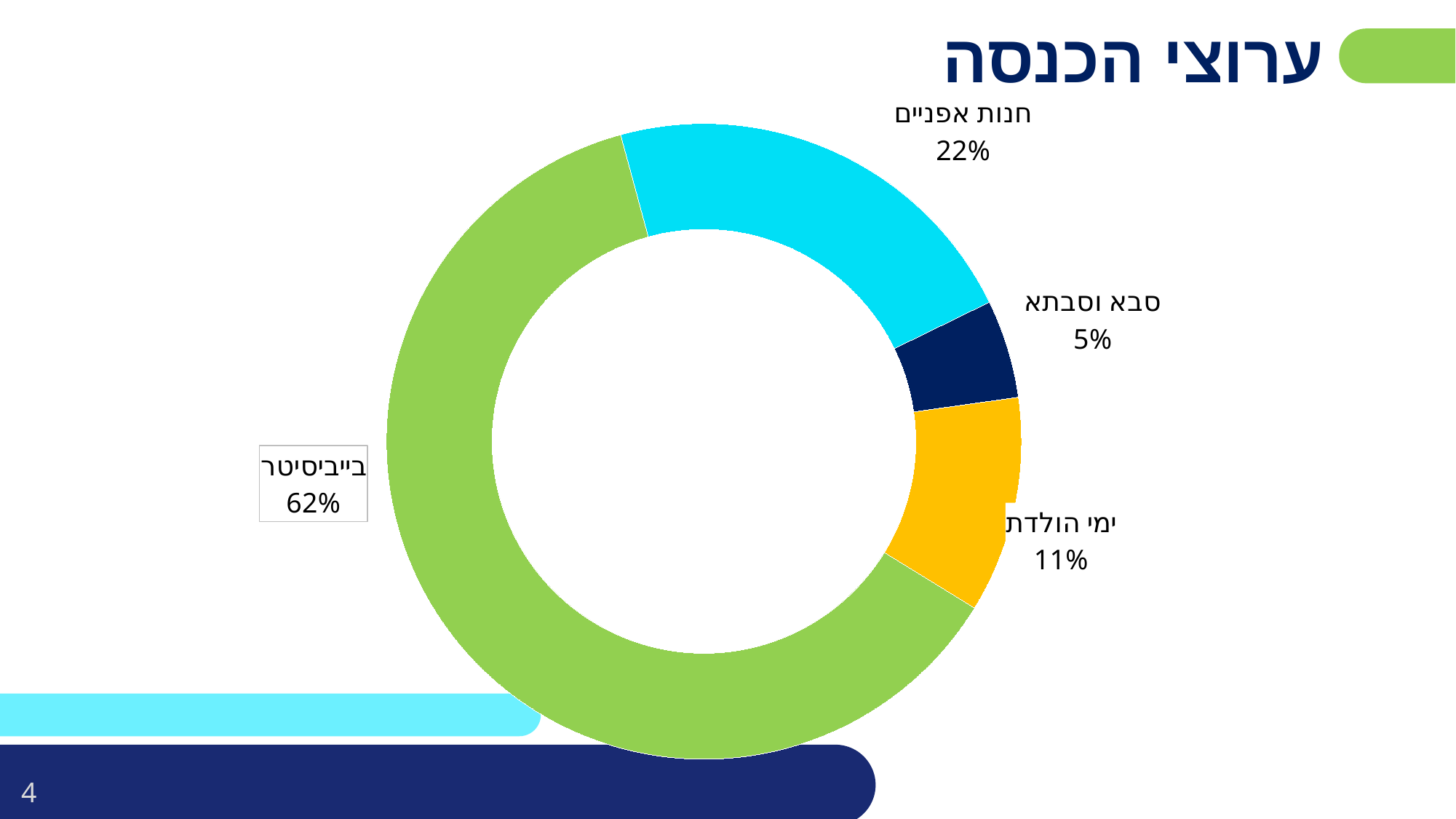
What type of chart is shown on the slide? Doughnut (pie) chart Which category has the smallest share of the chart? סבא וסבתא What colour is the slice for ימי הולדת? Yellow What share of the chart does ימי הולדת represent? 11% Which is larger, the share for ימי הולדת or the share for סבא וסבתא? ימי הולדת What share of the chart does חנות אפניים represent? 22% What is the title of the chart? ערוצי הכנסה Which category has the largest share of the chart? בייביסיטר How many categories are shown in the chart? 4 What share of the chart does בייביסיטר represent? 62% What is the difference in percentage points between בייביסיטר and חנות אפניים? 40 What share of the chart does סבא וסבתא represent? 5%